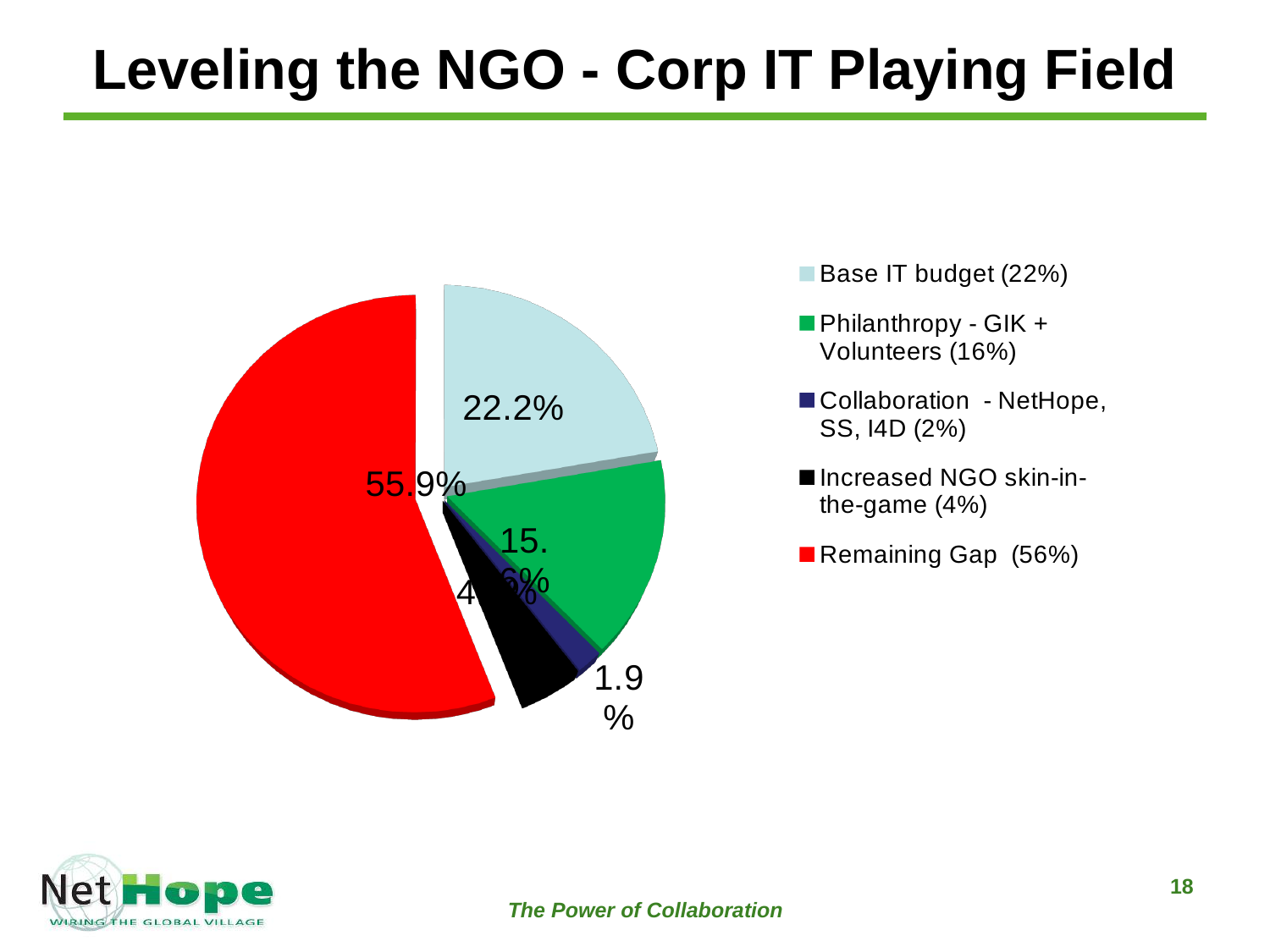
What percentage is shown on the pie slice for Remaining Gap? 55.9% What type of chart is shown on the slide? Pie chart How many slices does the pie chart have? 5 Which is larger, the Base IT budget slice or the Remaining Gap slice? Remaining Gap What percentage is shown on the pie slice for Collaboration - NetHope, SS, I4D? 1.9% Which is larger, the Base IT budget slice or the Philanthropy - GIK + Volunteers slice? Base IT budget What colour is the Remaining Gap slice in the pie chart? Red Which category has the smallest slice of the pie? Collaboration - NetHope, SS, I4D What percentage is shown on the pie slice for Base IT budget? 22.2% Which category has the largest slice of the pie? Remaining Gap What percentage does the legend give for Philanthropy - GIK + Volunteers? 16% What is the difference in percentage points between the Remaining Gap slice (55.9%) and the Base IT budget slice (22.2%)? 33.7 percentage points